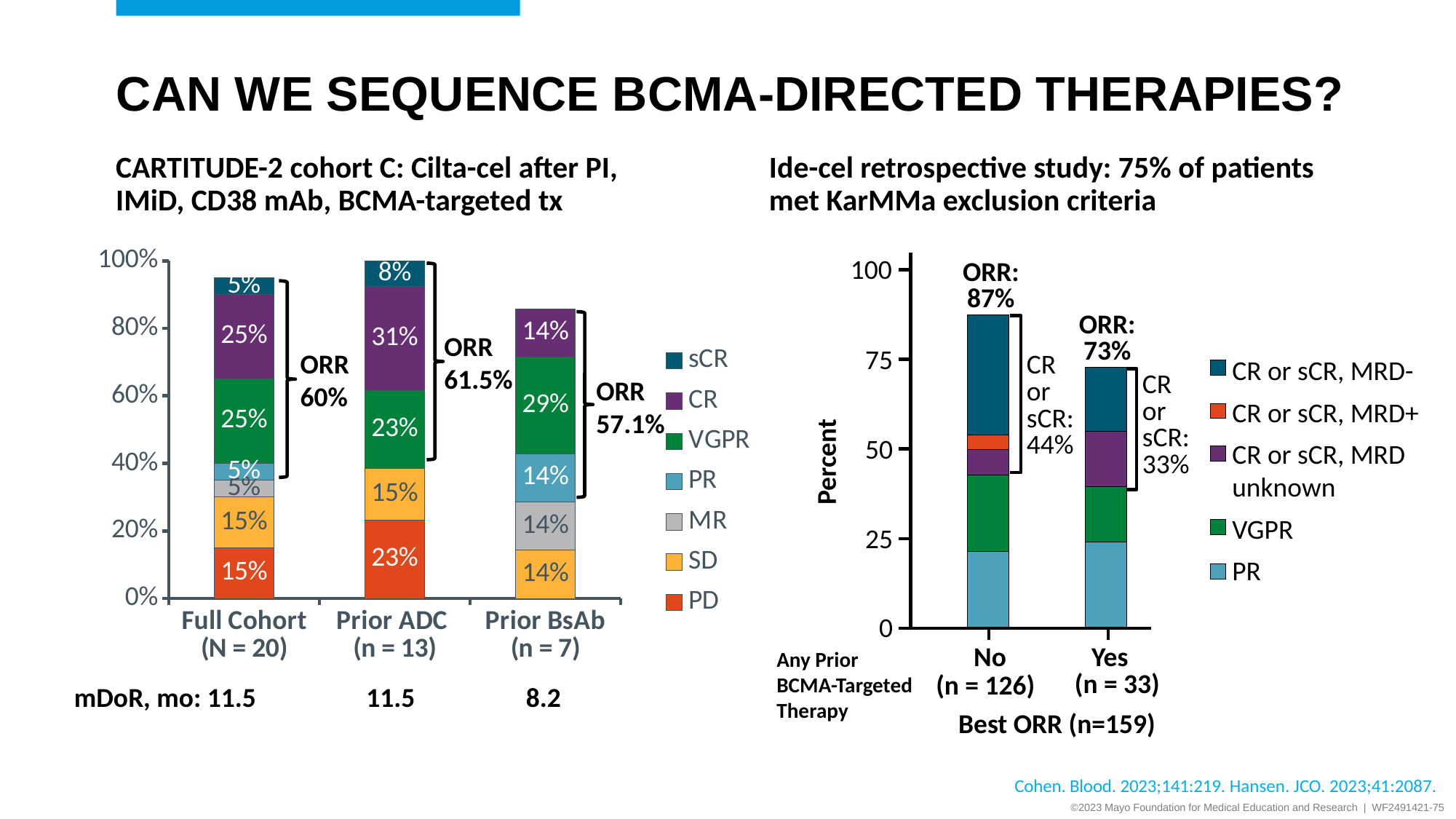
In the CARTITUDE-2 cohort C chart, what is the mDoR in months for the Prior BsAb group? 8.2 In the CARTITUDE-2 cohort C chart, what is the difference in PD percentage between the Prior ADC group and the Full Cohort? 8% What type of chart is the Ide-cel retrospective study chart? Stacked bar chart In the CARTITUDE-2 cohort C chart, what percentage of the Prior ADC group had CR? 31% In the CARTITUDE-2 cohort C chart, what is the ORR for the Full Cohort? 60% In the Ide-cel retrospective study chart, what is the ORR for patients with no prior BCMA-targeted therapy? 87% In the Ide-cel retrospective study chart, what is the difference in ORR between the No and Yes prior BCMA-targeted therapy groups? 14% In the CARTITUDE-2 cohort C chart, what percentage of the Prior BsAb group had VGPR? 29% In the CARTITUDE-2 cohort C chart, which group has the highest ORR? Prior ADC In the CARTITUDE-2 cohort C chart, how many response categories does the legend list? 7 In the Ide-cel retrospective study chart, what is the CR or sCR rate for patients with prior BCMA-targeted therapy? 33% In the Ide-cel retrospective study chart, is the PR value for the No prior BCMA-targeted therapy group greater or less than 25? less